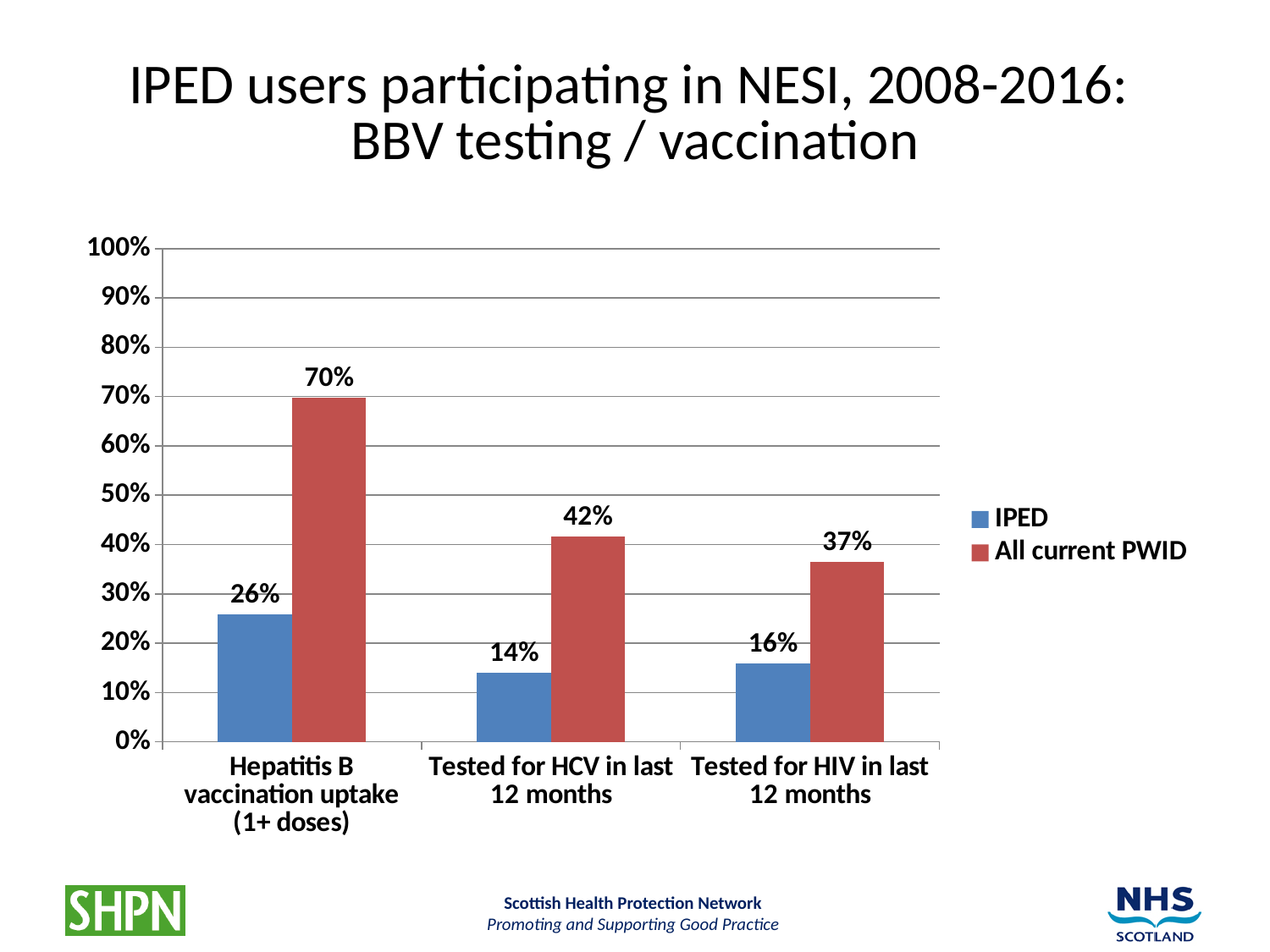
What is the difference between the All current PWID and IPED values for Hepatitis B vaccination uptake (1+ doses)? 44% Which category has the lowest IPED value? Tested for HCV in last 12 months How many categories are shown on the x axis? 3 What is the All current PWID value for Tested for HCV in last 12 months? 42% What is the IPED value for Hepatitis B vaccination uptake (1+ doses)? 26% Which series is shown in red? All current PWID What kind of chart is shown on the slide? Bar chart Which is larger for Tested for HCV in last 12 months: the IPED value or the All current PWID value? All current PWID What is the difference between the All current PWID and IPED values for Tested for HIV in last 12 months? 21% What is the IPED value for Tested for HIV in last 12 months? 16% How many series does the legend list? 2 Which category has the highest All current PWID value? Hepatitis B vaccination uptake (1+ doses)